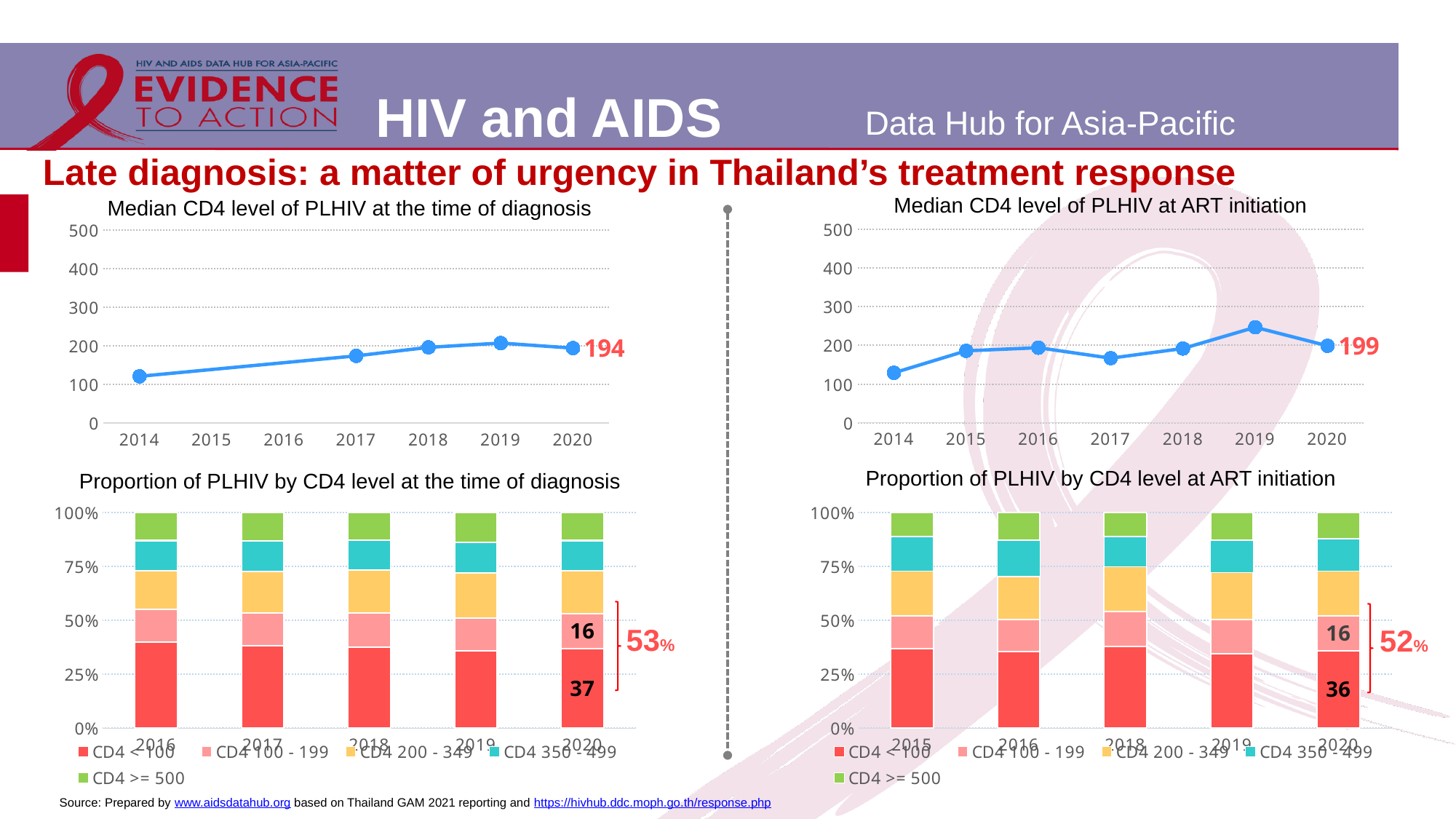
In the chart 'Median CD4 level of PLHIV at ART initiation', is the value for 2019 greater or less than 200? greater In the chart 'Proportion of PLHIV by CD4 level at the time of diagnosis', what is the labelled value for CD4 < 100 in 2020? 37 In the chart 'Proportion of PLHIV by CD4 level at ART initiation', what is the labelled value for CD4 < 100 in 2020? 36 How many series does the legend list in the chart 'Proportion of PLHIV by CD4 level at the time of diagnosis'? 5 What kind of chart is 'Median CD4 level of PLHIV at ART initiation'? Line chart How many data points are plotted in the chart 'Median CD4 level of PLHIV at the time of diagnosis'? 5 What is the difference between the 2020 median CD4 level at ART initiation and the 2020 median CD4 level at the time of diagnosis? 5 In the chart 'Median CD4 level of PLHIV at ART initiation', what is the value for 2020? 199 Comparing the 2020 values, which is larger: the median CD4 level at the time of diagnosis or at ART initiation? At ART initiation In the chart 'Median CD4 level of PLHIV at the time of diagnosis', is the value for 2014 greater or less than 200? less In the chart 'Median CD4 level of PLHIV at the time of diagnosis', what is the value for 2020? 194 What kind of chart is 'Proportion of PLHIV by CD4 level at ART initiation'? Bar chart